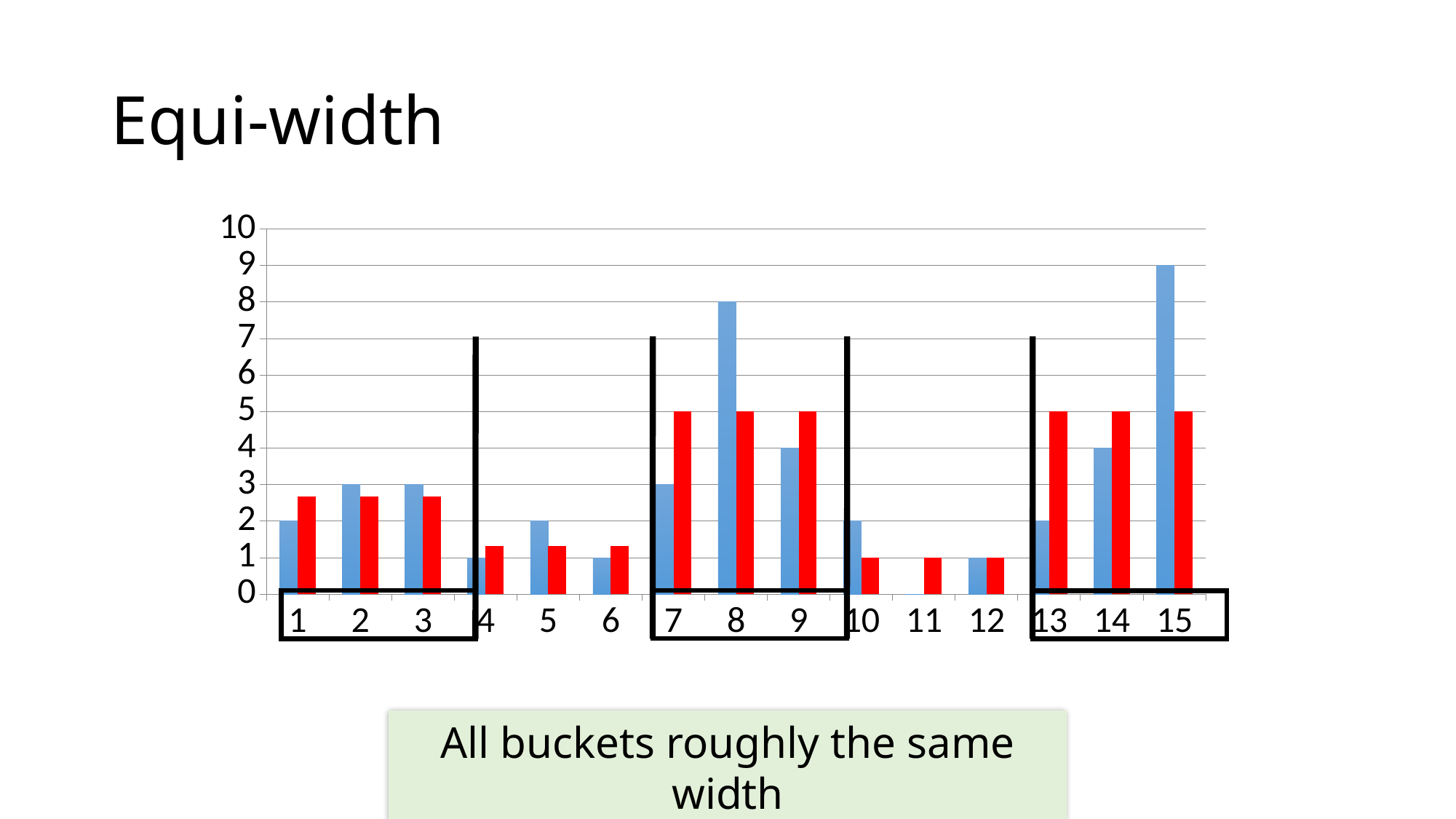
What is the difference between the blue bar for category 15 and the blue bar for category 8? 1 What kind of chart is shown on the slide? bar chart What is the value of the blue bar for category 8? 8 Which category has the tallest blue bar? 15 What is the value of the red bar for category 10? 1 What is the value of the red bar for category 8? 5 What is the value of the blue bar for category 15? 9 Is the value of the red bar for category 2 greater or less than 5? less How many categories are shown on the x axis of the chart? 15 For category 8, which bar is taller, the blue one or the red one? blue What is the title of the slide containing the chart? Equi-width What is the value of the blue bar for category 14? 4